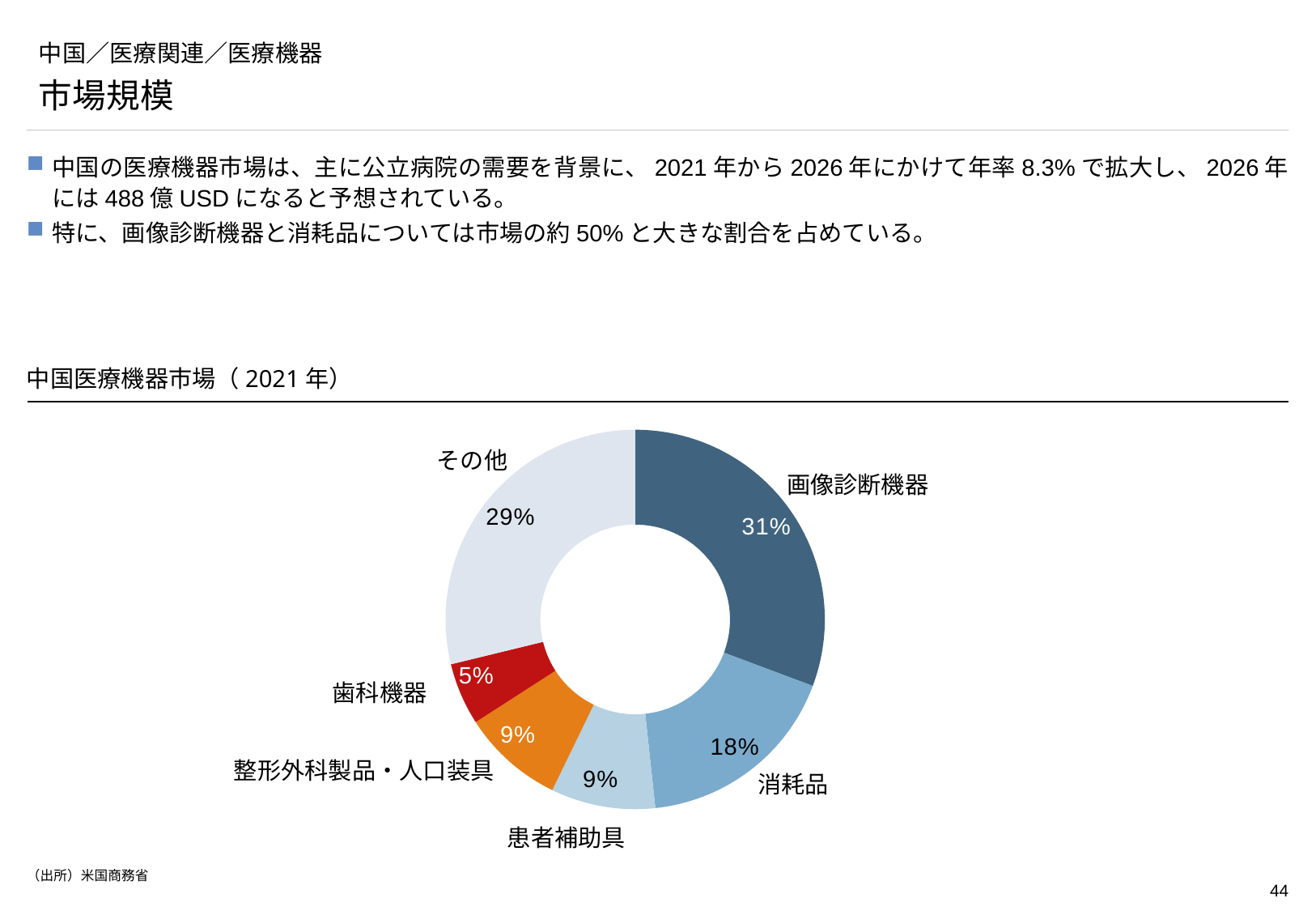
How many categories are shown in the chart? 6 What is the title of the chart? 中国医療機器市場（2021年） What share of the market does 消耗品 account for? 18% What share is shown for その他? 29% Which category has the largest share of the market? 画像診断機器 Which has a larger share, その他 or 消耗品? その他 What is the share shown for 歯科機器? 5% Which category has the smallest share of the market? 歯科機器 What share of the China medical device market (2021) does 画像診断機器 hold? 31% What is the combined share of 画像診断機器 and 消耗品? 49% What is the difference in share between 画像診断機器 and 消耗品? 13 percentage points What kind of chart is used to show the China medical device market (2021)? Pie chart (doughnut)